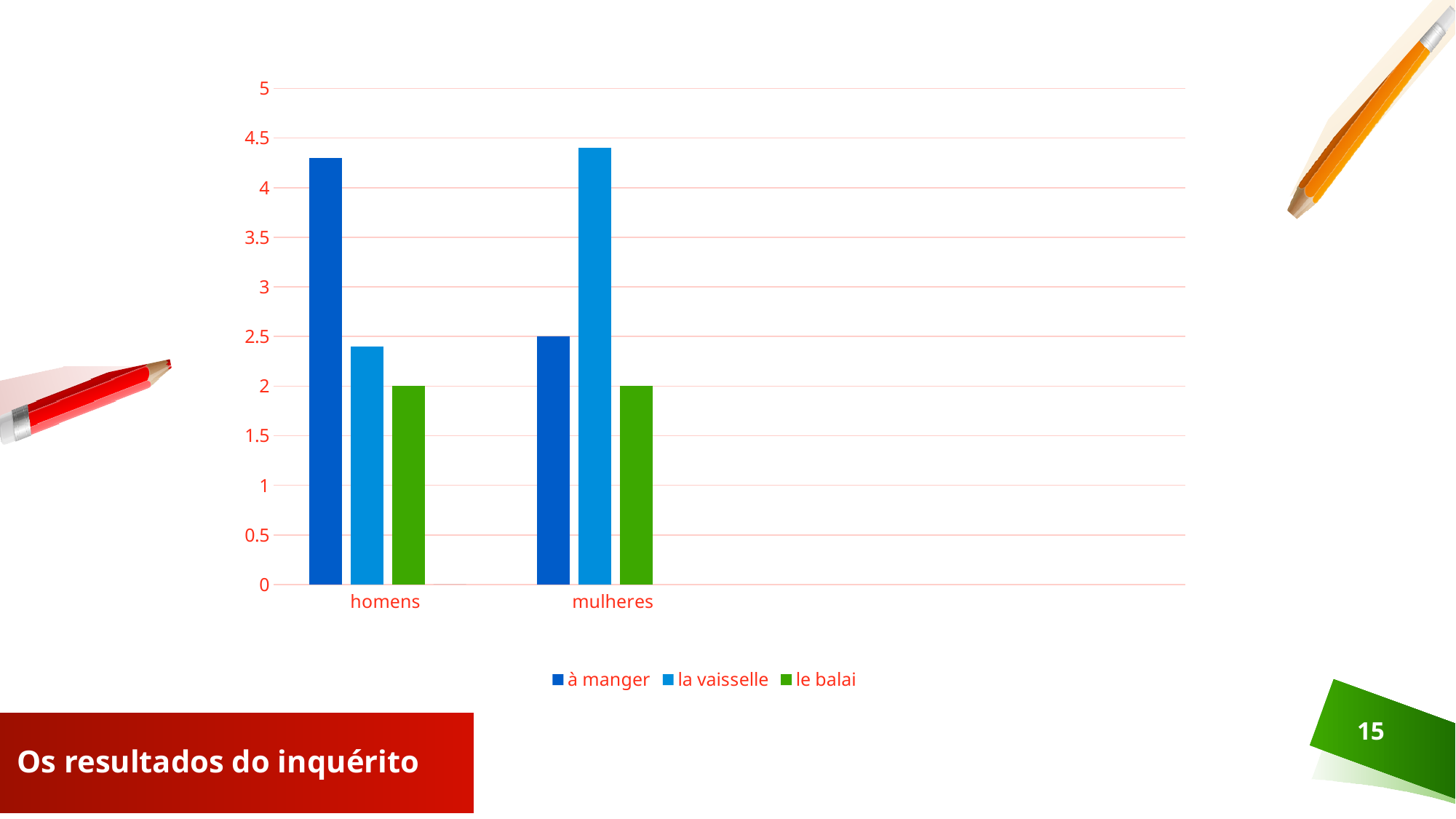
What kind of chart is shown on the slide? bar chart What colour represents le balai in the legend? green How many categories are shown on the x axis? 2 What is the value of le balai for mulheres? 2 Which is larger for la vaisselle: homens or mulheres? mulheres How many series does the legend list? 3 Is the value of à manger for homens greater or less than 4? greater Is the value of la vaisselle for mulheres greater or less than 4? greater Which series has the lowest value for mulheres? le balai What is the value of à manger for mulheres? 2.5 What is the value of le balai for homens? 2 Which series has the highest value for homens? à manger